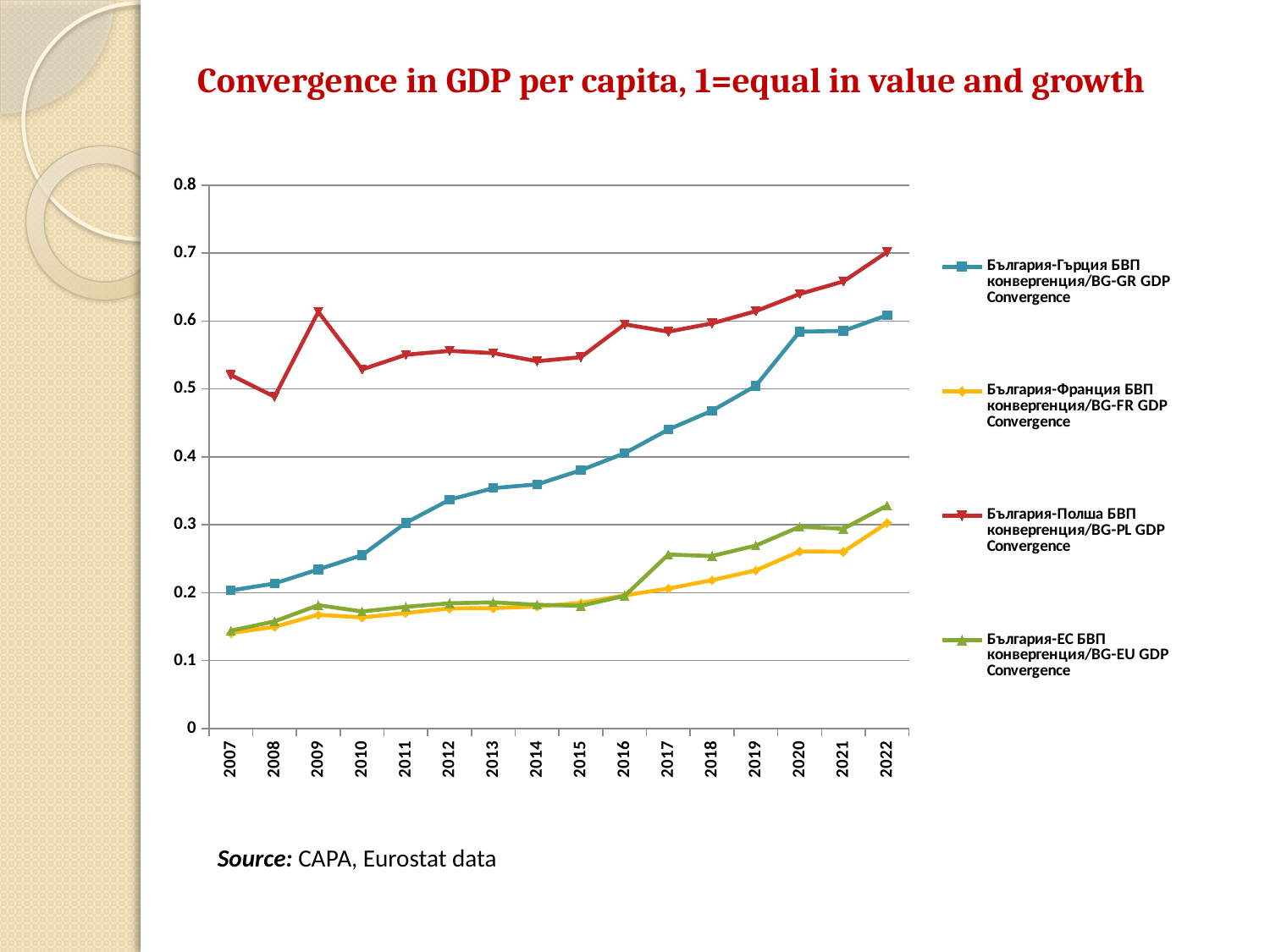
How many series does the legend list? 4 Which series has the highest value in 2022? България-Полша БВП конвергенция/BG-PL GDP Convergence What is the title of the chart? Convergence in GDP per capita, 1=equal in value and growth In 2015, which is larger: the value for BG-GR GDP Convergence or BG-EU GDP Convergence? BG-GR GDP Convergence Is the value for BG-PL GDP Convergence in 2007 greater or less than 0.5? greater Is the value for BG-GR GDP Convergence in 2020 greater or less than 0.5? greater Is the value for BG-FR GDP Convergence in 2007 greater or less than 0.2? less Which series has the lowest value in 2017? България-Франция БВП конвергенция/BG-FR GDP Convergence How many years are plotted along the x axis? 16 Does the BG-GR GDP Convergence series generally rise or fall from 2007 to 2022? rise What kind of chart is shown on the slide? line chart What source is cited below the chart? CAPA, Eurostat data